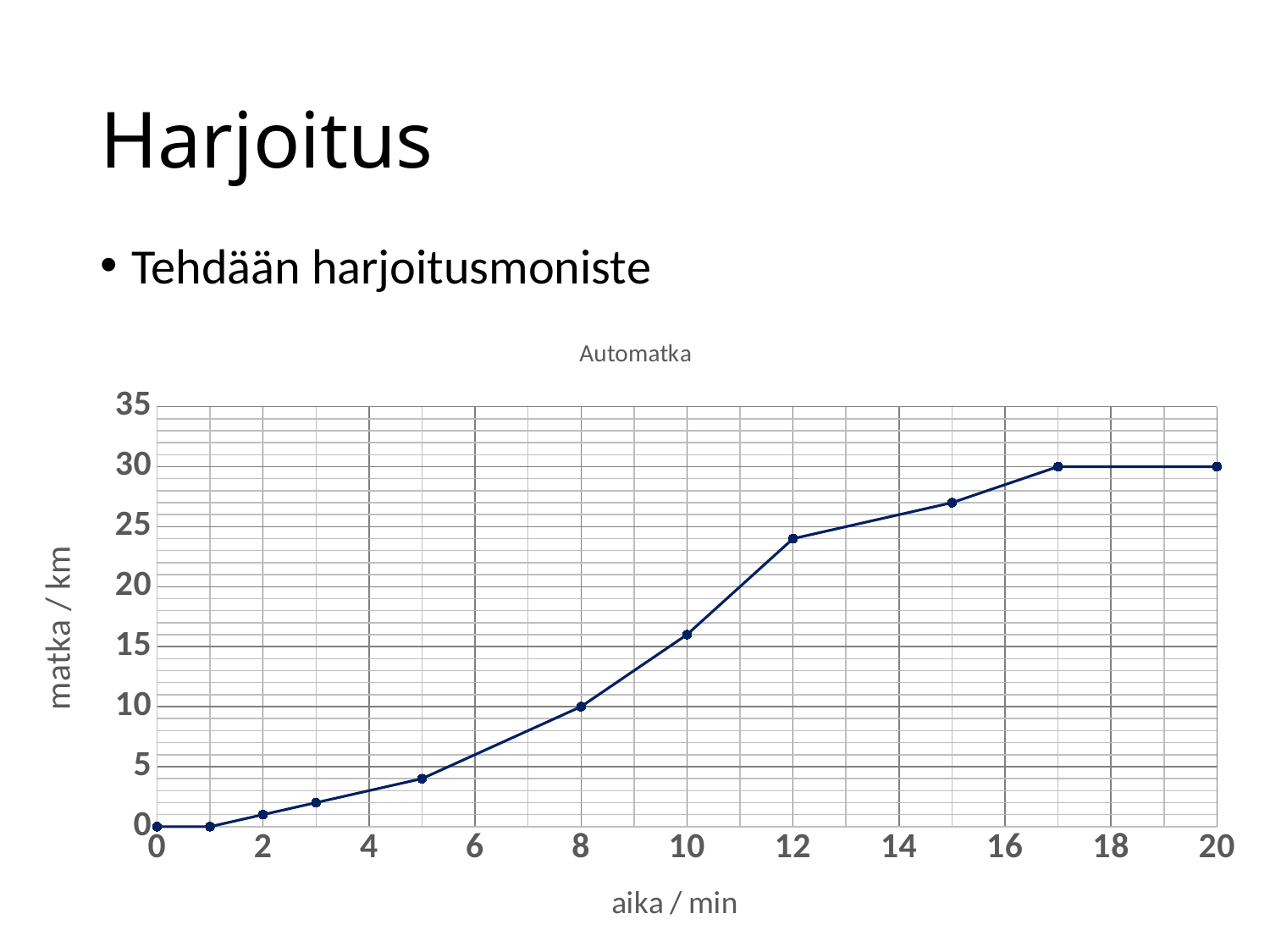
Is the distance at 12 minutes greater or less than 20? greater What kind of chart is shown on the slide? line chart How many data points are plotted on the line? 11 What is the title of the chart? Automatka Is the distance at 5 minutes greater or less than 5? less What is the distance (matka) at 8 minutes? 10 What is the distance (matka) at 17 minutes? 30 What is the distance (matka) at 0 minutes? 0 Is the distance at 15 minutes greater or less than 25? greater What is the distance (matka) at 20 minutes? 30 By how much does the distance increase between 8 minutes and 17 minutes? 20 What is the label of the y axis? matka / km